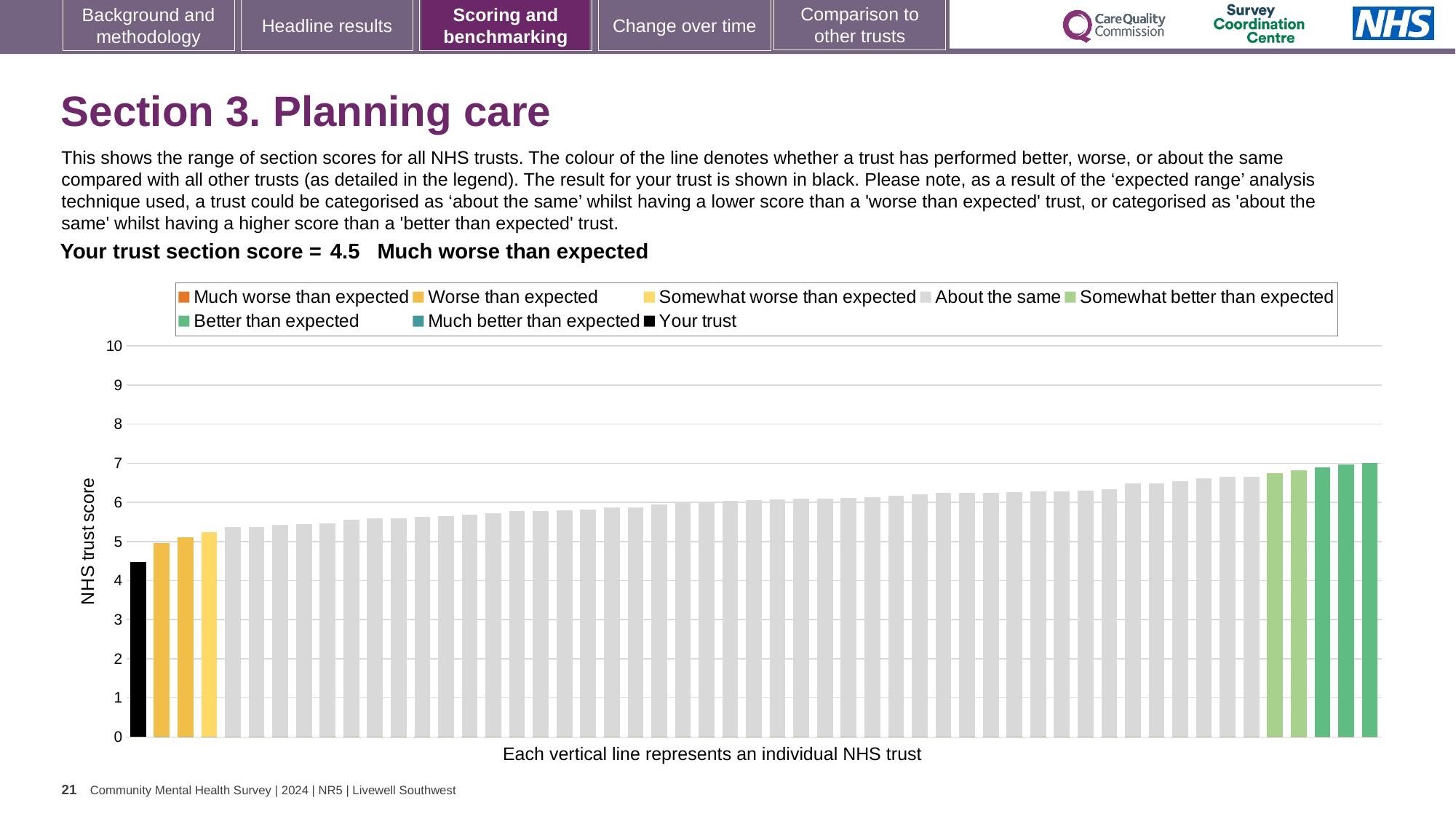
What colour is the bar representing your trust? black What is the label on the vertical axis? NHS trust score What kind of chart is shown on the slide? bar chart Is the value of the tallest bar greater or less than 8? less Which bar is the lowest on the chart? Your trust How many entries does the legend list? 8 Is the value of the tallest bar greater or less than 6? greater What is your trust's section score for Planning care? 4.5 Do the bar values rise or fall from left to right along the x axis? rise Is the value for your trust greater or less than 5? less How is your trust's section score of 4.5 categorised? Much worse than expected